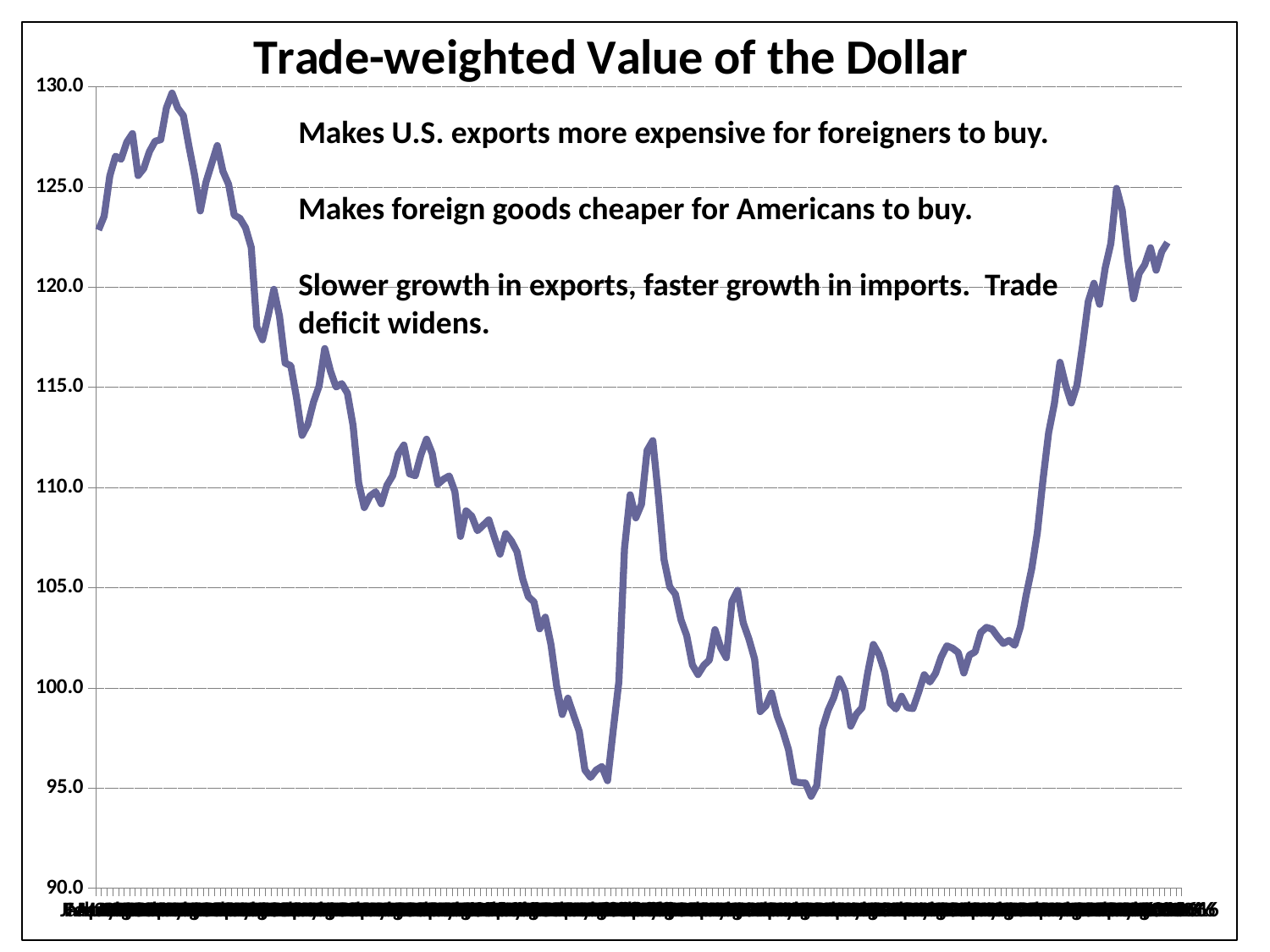
Is the value at the rightmost point of the line greater or less than 120? greater Is the highest point of the line greater or less than 130? less Does the line rise or fall from its leftmost point to its lowest point? fall What is the highest value shown on the vertical axis? 130.0 Does the line rise or fall from its lowest point to its rightmost point? rise Is the lowest point of the line greater or less than 90? greater What kind of chart is shown on the slide? line chart Is the leftmost point of the line higher or lower than the rightmost point? higher What is the title of the chart? Trade-weighted Value of the Dollar